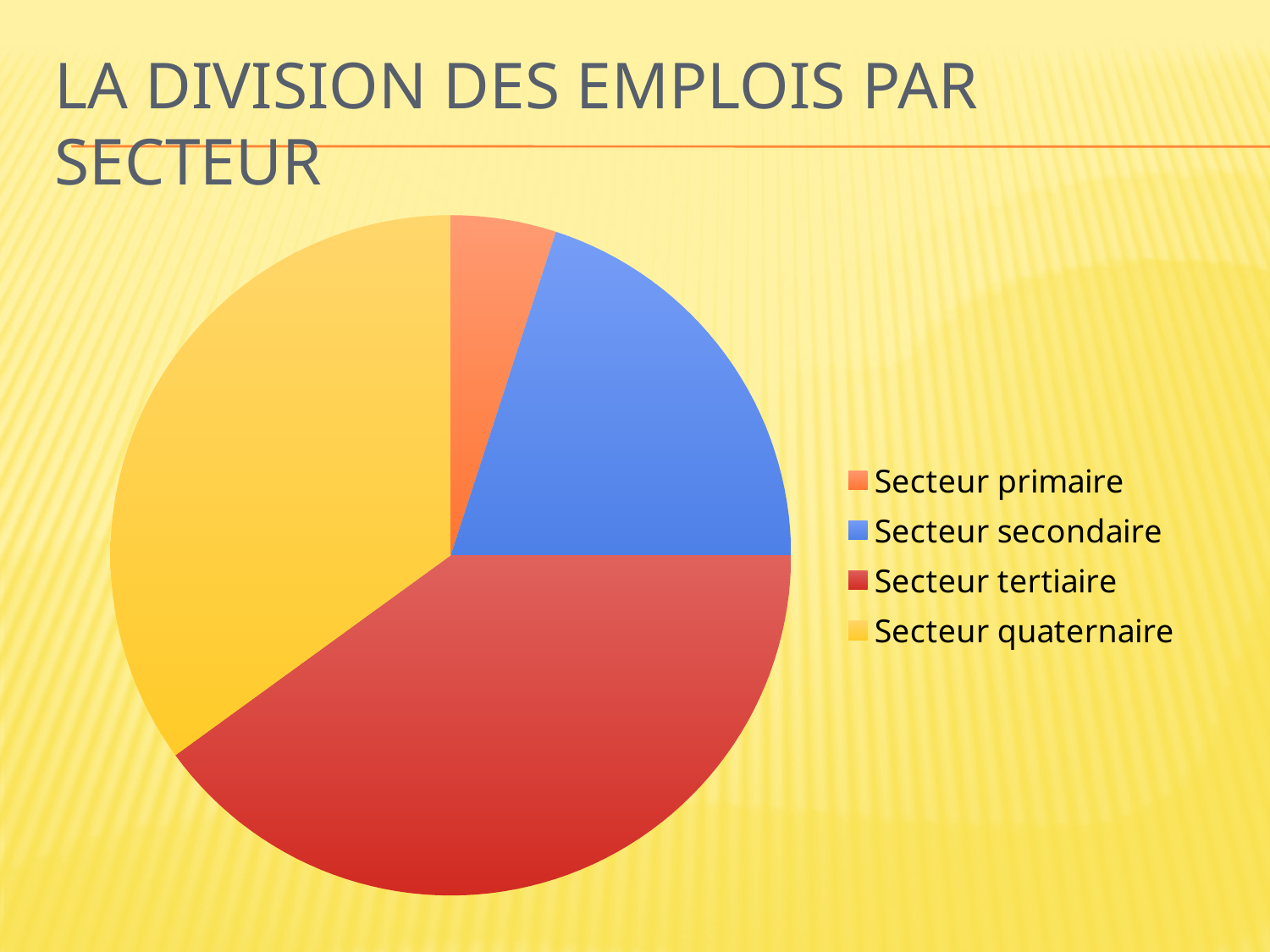
What colour is the slice for Secteur secondaire? Blue What is the title of the slide containing the pie chart? La division des emplois par secteur Which slice is larger, Secteur primaire or Secteur secondaire? Secteur secondaire How many slices does the pie chart have? 4 Which sector has the smallest slice of the pie? Secteur primaire How many entries does the legend list? 4 Which slice is larger, Secteur secondaire or Secteur quaternaire? Secteur quaternaire What kind of chart is shown on the slide? Pie chart Which sector has the largest slice of the pie? Secteur tertiaire Which slice is larger, Secteur tertiaire or Secteur quaternaire? Secteur tertiaire